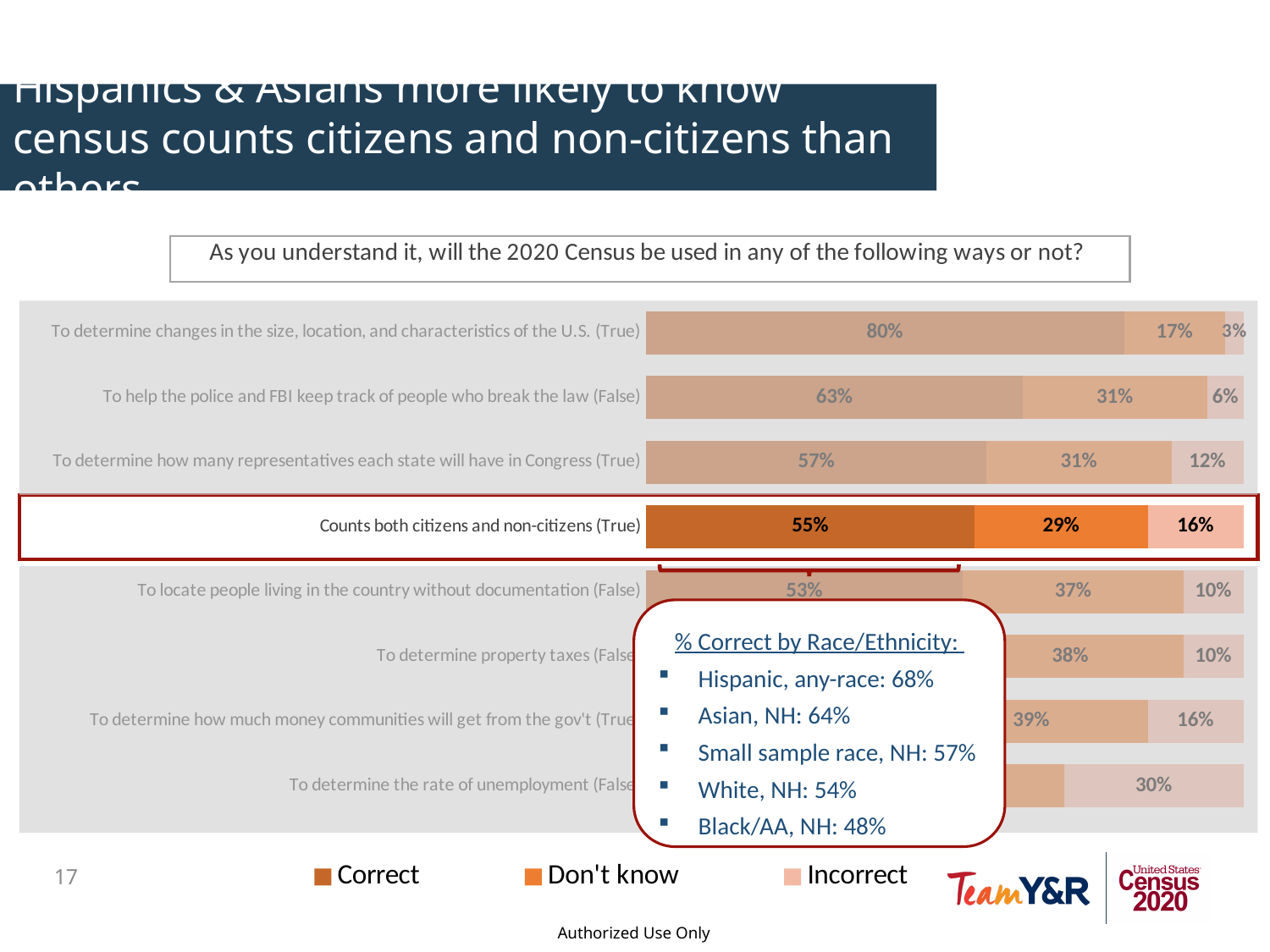
Which has a larger 'Don't know' share: 'To locate people living in the country without documentation (False)' or 'To determine how many representatives each state will have in Congress (True)'? To locate people living in the country without documentation (False) What is the total of the stacked bar for 'To determine changes in the size, location, and characteristics of the U.S. (True)'? 100% Which statement has the lowest 'Incorrect' percentage? To determine changes in the size, location, and characteristics of the U.S. (True) Which statement has the highest 'Correct' percentage? To determine changes in the size, location, and characteristics of the U.S. (True) What kind of chart is shown on the slide? Stacked bar chart What is the 'Incorrect' percentage for 'To help the police and FBI keep track of people who break the law (False)'? 6% What is the difference between the 'Correct' percentages for 'To help the police and FBI keep track of people who break the law (False)' and 'Counts both citizens and non-citizens (True)'? 8% What percentage answered correctly that the census is used to determine changes in the size, location, and characteristics of the U.S.? 80% What is the 'Don't know' percentage for 'Counts both citizens and non-citizens (True)'? 29% According to the callout box, what is the % correct for Hispanic, any-race on the citizens and non-citizens question? 68% How many series does the legend list? 3 How many statements (categories) are shown in the chart? 8